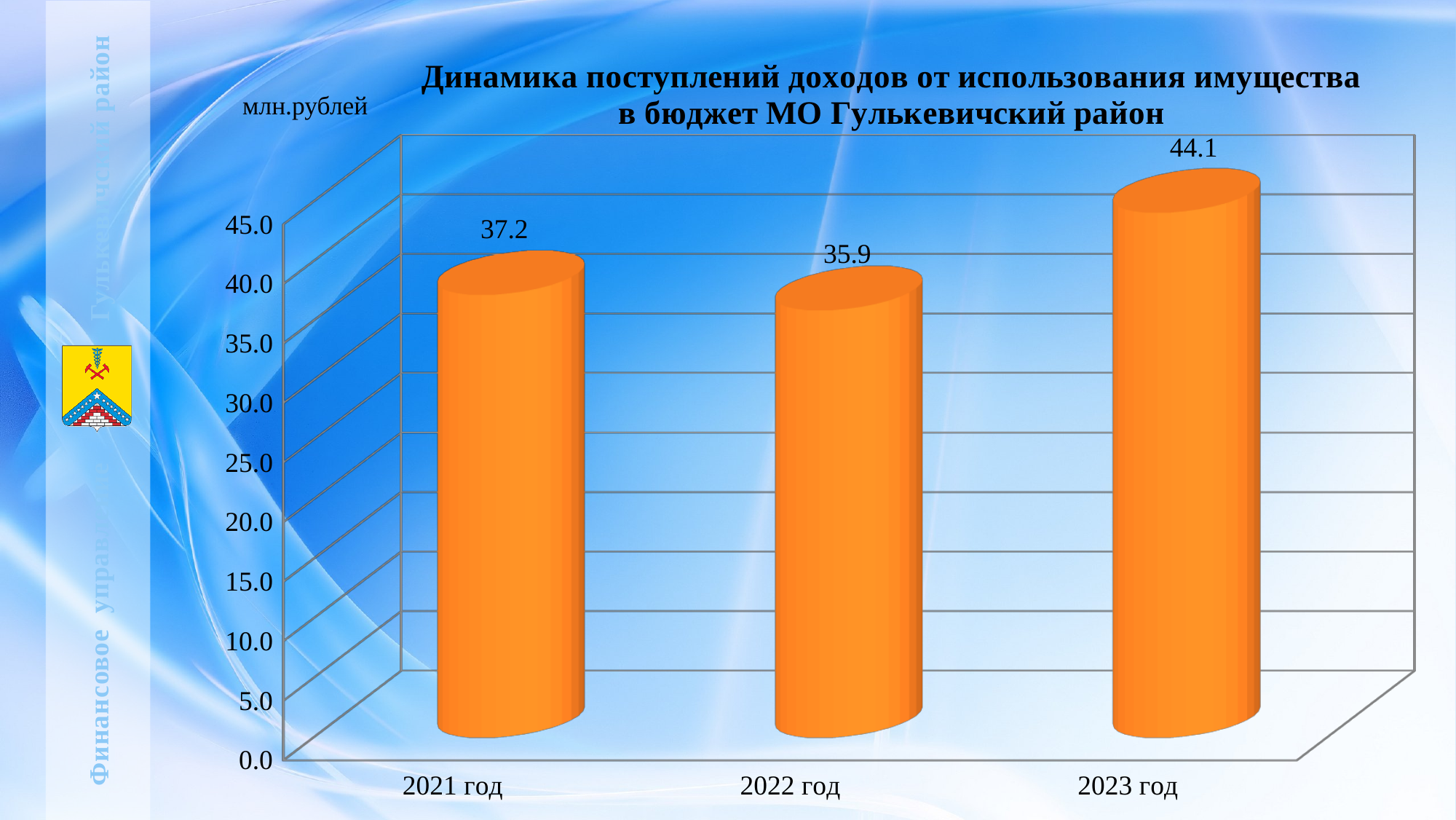
What is the value for 2022 год? 35.9 What kind of chart is this? bar chart What is the value for 2021 год? 37.2 Which year has the highest value? 2023 год What is the difference between the values for 2021 год and 2022 год? 1.3 What is the value for 2023 год? 44.1 What is the difference between the values for 2023 год and 2022 год? 8.2 What unit is shown above the vertical axis? млн.рублей How many years are shown on the chart? 3 Which is larger, the value for 2021 год or the value for 2023 год? 2023 год Which year has the lowest value? 2022 год What is the title of the chart? Динамика поступлений доходов от использования имущества в бюджет МО Гулькевичский район